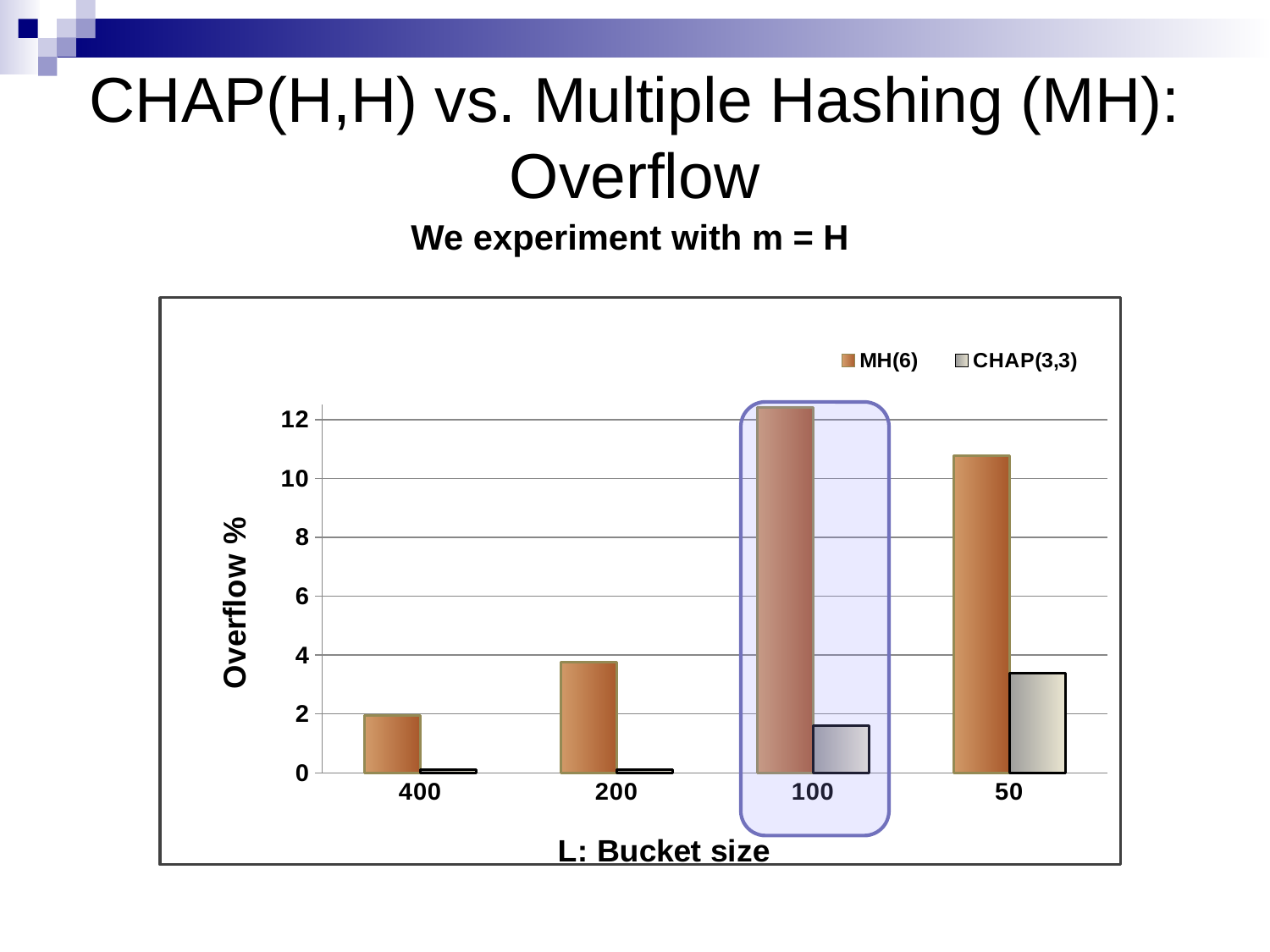
Is the CHAP(3,3) overflow for bucket size 50 greater or less than 4? less For which bucket size is the MH(6) overflow highest? 100 How many series does the legend list? 2 For which bucket size is the MH(6) overflow lowest? 400 How many bucket size categories are shown on the x axis? 4 At bucket size 100, which series has the larger overflow, MH(6) or CHAP(3,3)? MH(6) What kind of chart is shown on the slide? bar chart Is the MH(6) overflow for bucket size 200 greater or less than 4? less For which bucket size is the CHAP(3,3) overflow highest? 50 Is the MH(6) overflow for bucket size 100 greater or less than 10? greater What is the label of the y axis? Overflow % Does the CHAP(3,3) overflow rise or fall as the bucket size goes from 400 to 50 along the x axis? rise